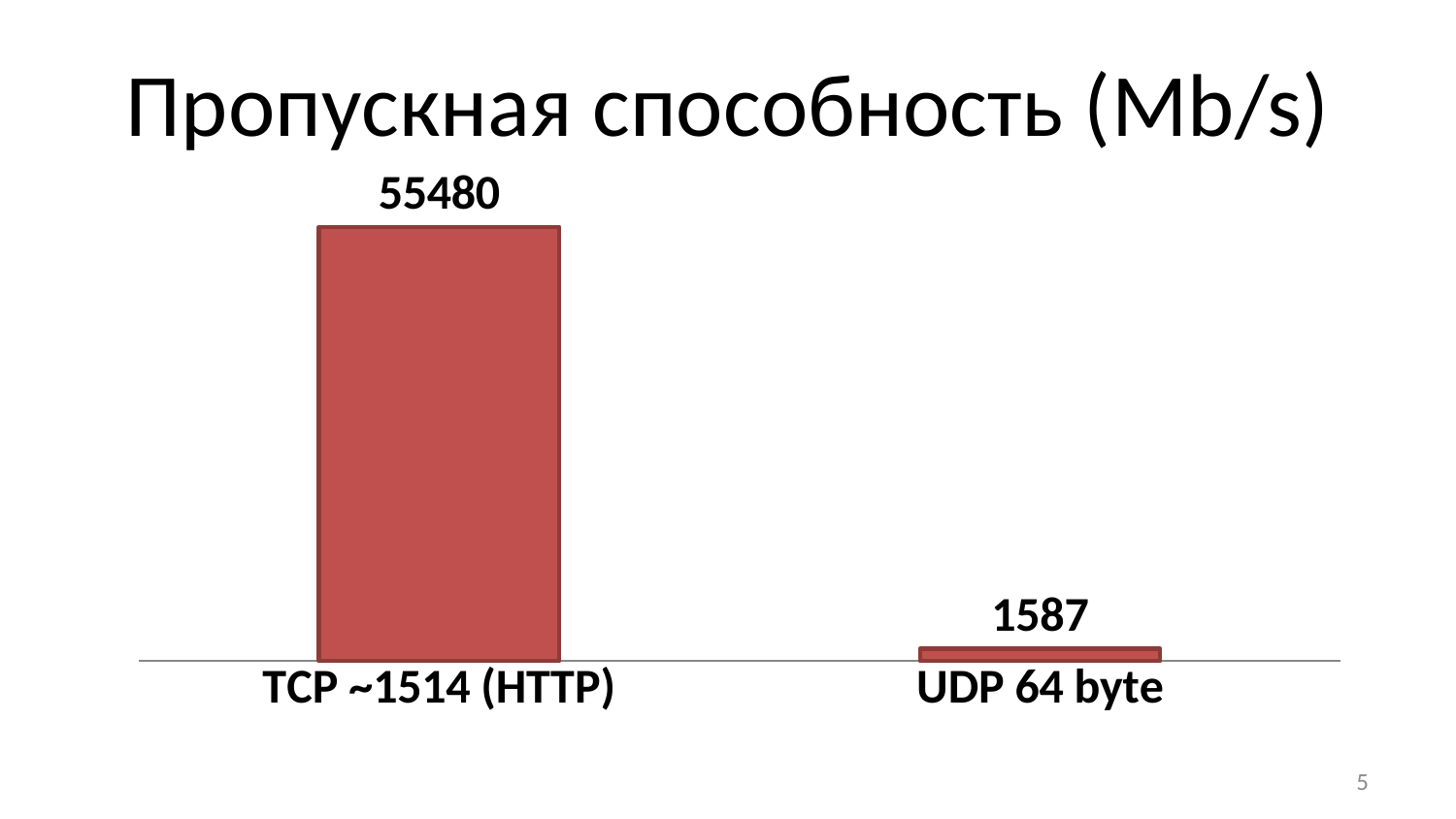
What is the title of the slide? Пропускная способность (Mb/s) How many categories are shown in the chart? 2 What is the value for TCP ~1514 (HTTP)? 55480 What is the difference between the values for TCP ~1514 (HTTP) and UDP 64 byte? 53893 Which category has the lowest value? UDP 64 byte Which category has the highest value? TCP ~1514 (HTTP) What colour are the bars in the chart? red What kind of chart is shown on the slide? bar chart What is the value for UDP 64 byte? 1587 Which is larger, the value for TCP ~1514 (HTTP) or the value for UDP 64 byte? TCP ~1514 (HTTP)